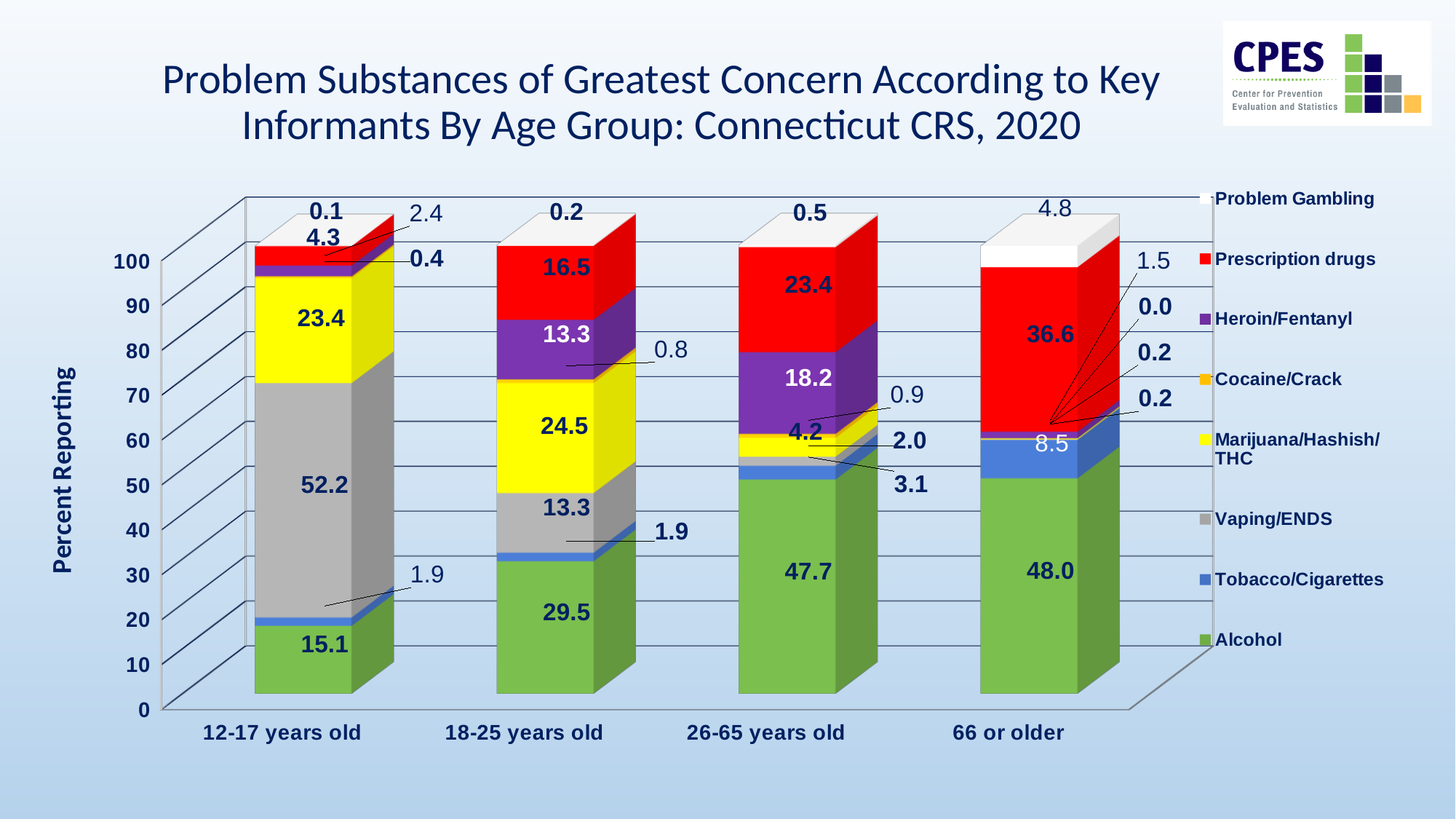
What is the Prescription drugs value for the 66 or older group? 36.6 How many series does the legend list? 8 How many age groups are shown on the x axis? 4 What kind of chart is shown on the slide? Stacked bar chart What is the difference between the Prescription drugs values for the 26-65 years old and 18-25 years old groups? 6.9 Which age group has the lowest Problem Gambling value? 12-17 years old What is the Alcohol value for the 18-25 years old group? 29.5 What is the Problem Gambling value for the 66 or older group? 4.8 Which age group has the highest Alcohol value? 66 or older Which group has the larger Heroin/Fentanyl value, 18-25 years old or 26-65 years old? 26-65 years old What is the Vaping/ENDS value for the 12-17 years old group? 52.2 Does the Alcohol value rise or fall as the age groups move from 12-17 years old to 66 or older? Rises